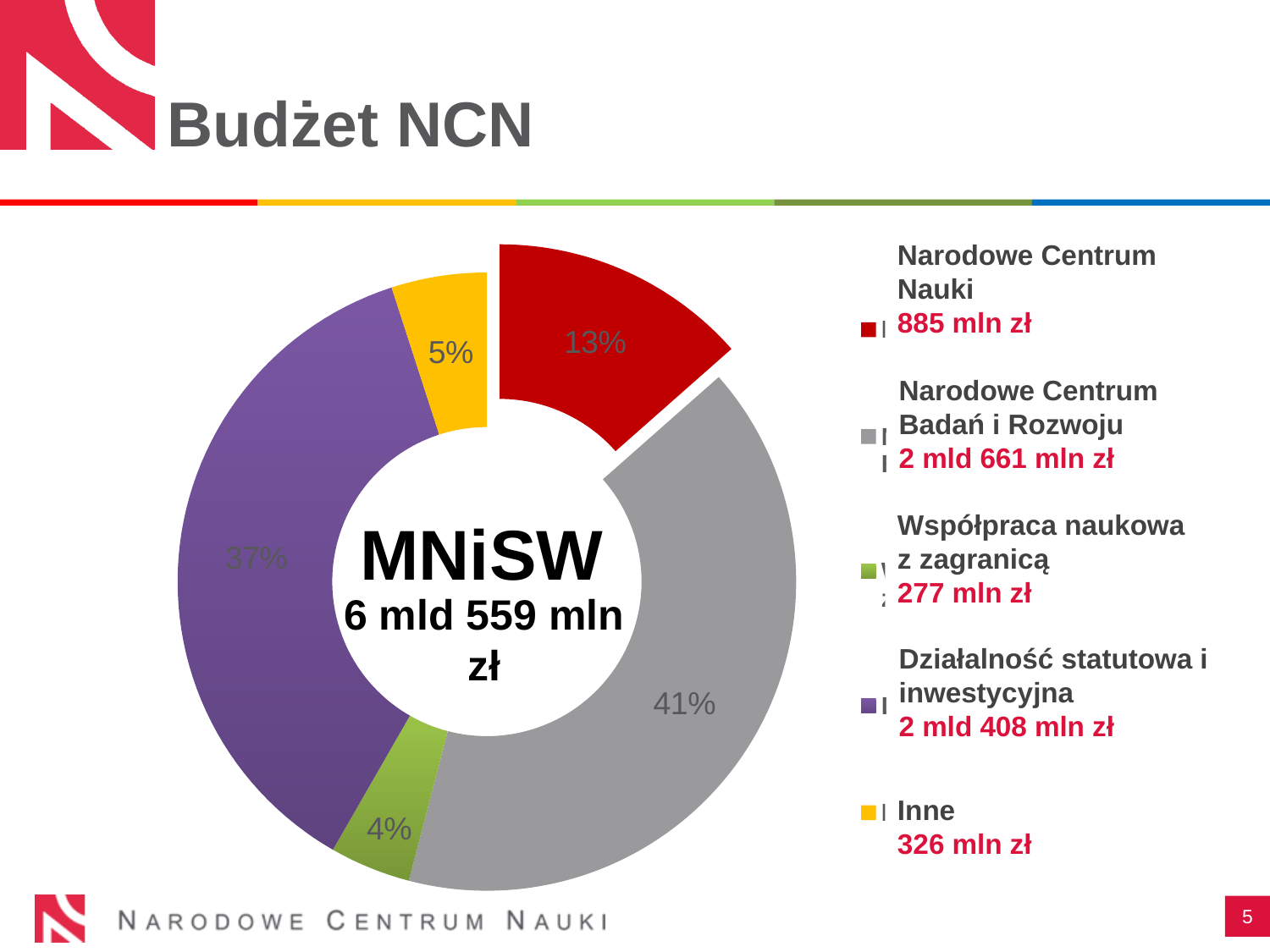
Which category has the largest slice of the pie? Narodowe Centrum Badań i Rozwoju How many slices does the pie chart have? 5 What is the difference in percentage points between the Narodowe Centrum Badań i Rozwoju slice and the Działalność statutowa i inwestycyjna slice? 4 percentage points Which slice is larger: Narodowe Centrum Nauki or Inne? Narodowe Centrum Nauki What share of the pie does Narodowe Centrum Nauki represent? 13% Which category has the smallest slice of the pie? Współpraca naukowa z zagranicą What share of the pie does Działalność statutowa i inwestycyjna represent? 37% What total amount is shown in the centre of the donut chart for MNiSW? 6 mld 559 mln zł What is the title of the slide containing the chart? Budżet NCN What share of the pie does Narodowe Centrum Badań i Rozwoju represent? 41% What kind of chart is shown on the slide? Pie chart (donut)